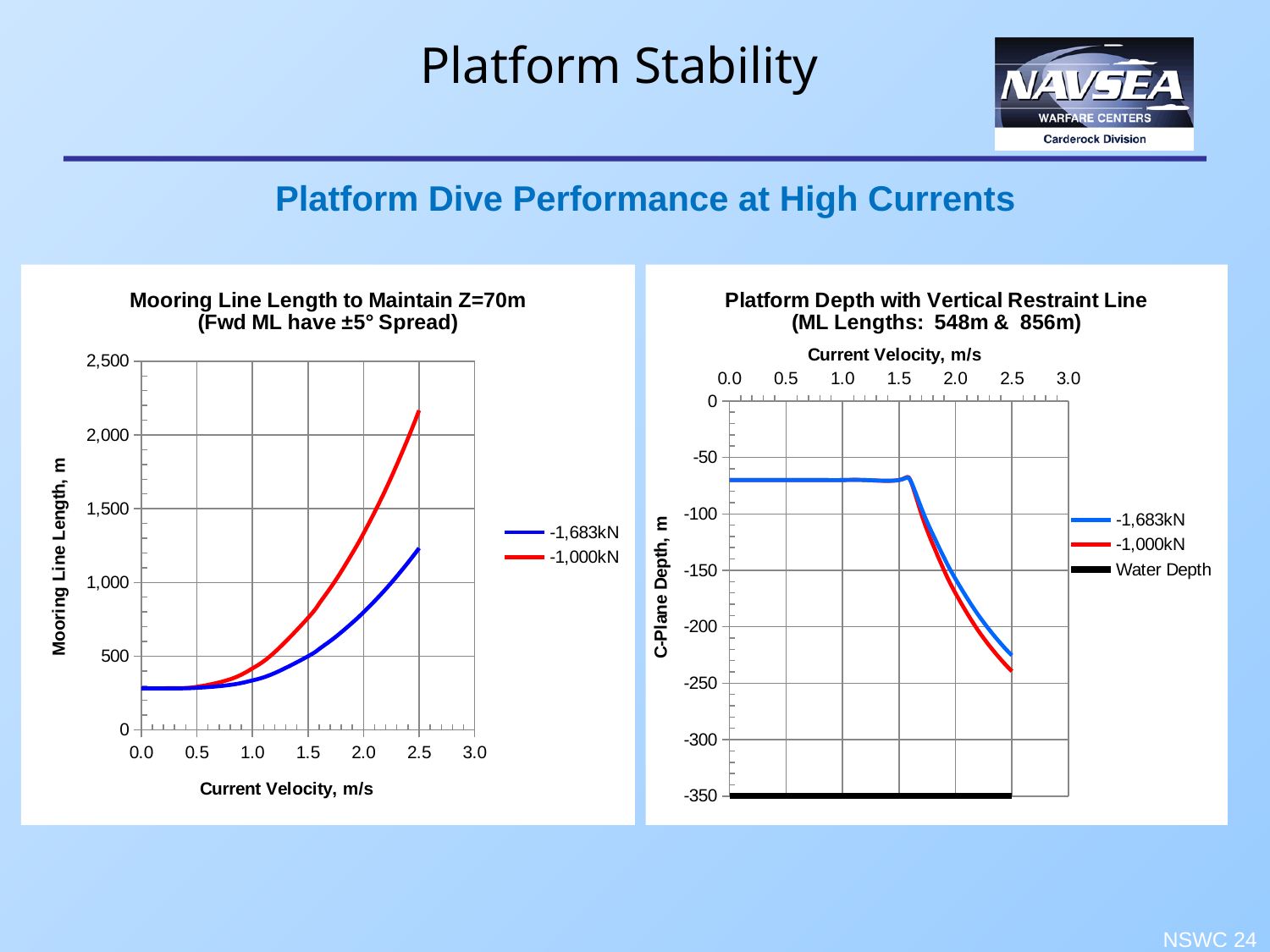
In the left chart, 'Mooring Line Length to Maintain Z=70m', do the mooring line lengths rise or fall as current velocity increases? rise In the left chart, 'Mooring Line Length to Maintain Z=70m', is the value for -1,000kN at 2.5 m/s greater or less than 2,000? greater In the left chart, 'Mooring Line Length to Maintain Z=70m', is the value for -1,683kN at 2.5 m/s greater or less than 1,500? less In the right chart, 'Platform Depth with Vertical Restraint Line', which series is deeper (more negative) at 2.5 m/s, -1,683kN or -1,000kN? -1,000kN In the right chart, 'Platform Depth with Vertical Restraint Line', is the value for -1,000kN at 2.5 m/s greater or less than -200? less In the right chart, 'Platform Depth with Vertical Restraint Line', does the C-Plane depth rise or fall as current velocity increases beyond 1.5 m/s? fall How many series does the legend of the right chart, 'Platform Depth with Vertical Restraint Line', list? 3 What kind of chart is the left chart, 'Mooring Line Length to Maintain Z=70m'? line chart In the right chart, 'Platform Depth with Vertical Restraint Line', at what C-Plane depth does the Water Depth line sit? -350 What is the label of the y axis of the left chart, 'Mooring Line Length to Maintain Z=70m'? Mooring Line Length, m In the left chart, 'Mooring Line Length to Maintain Z=70m', which series has the larger mooring line length at 2.0 m/s, -1,683kN or -1,000kN? -1,000kN How many series does the legend of the left chart, 'Mooring Line Length to Maintain Z=70m', list? 2